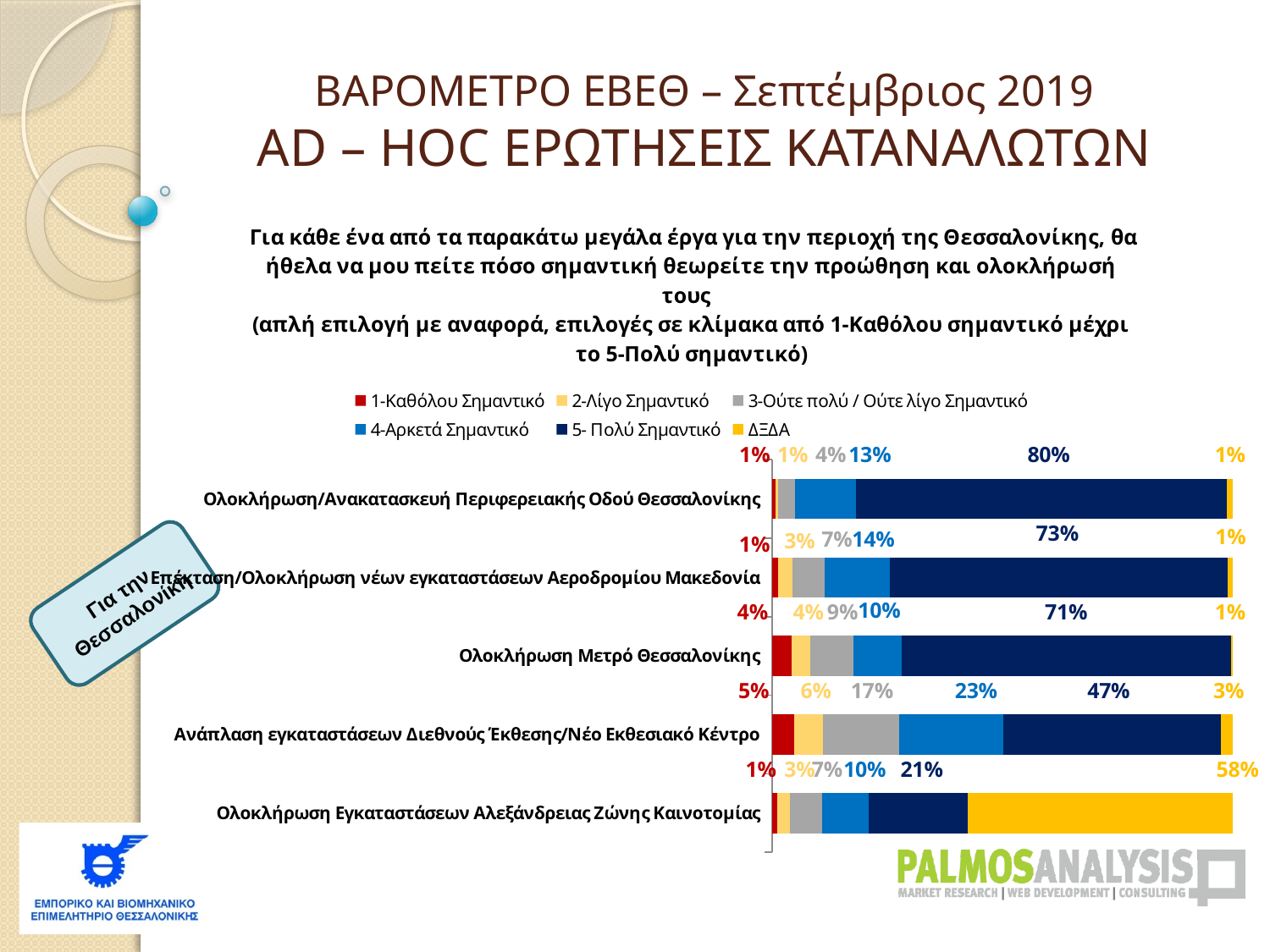
Which colour represents the '5- Πολύ Σημαντικό' series in the chart? Dark blue Which project has the lowest '5- Πολύ Σημαντικό' value? Ολοκλήρωση Εγκαταστάσεων Αλεξάνδρειας Ζώνης Καινοτομίας How many projects (categories) are plotted in the chart? 5 What is the '5- Πολύ Σημαντικό' value for Ολοκλήρωση/Ανακατασκευή Περιφερειακής Οδού Θεσσαλονίκης? 80% What is the difference between the '5- Πολύ Σημαντικό' values for Ολοκλήρωση/Ανακατασκευή Περιφερειακής Οδού Θεσσαλονίκης and Ολοκλήρωση Μετρό Θεσσαλονίκης? 9% What is the '4-Αρκετά Σημαντικό' value for Ανάπλαση εγκαταστάσεων Διεθνούς Έκθεσης/Νέο Εκθεσιακό Κέντρο? 23% What is the '3-Ούτε πολύ / Ούτε λίγο Σημαντικό' value for Ολοκλήρωση Μετρό Θεσσαλονίκης? 9% What kind of chart is shown on the slide? Stacked bar chart What is the 'ΔΞΔΑ' value for Ολοκλήρωση Εγκαταστάσεων Αλεξάνδρειας Ζώνης Καινοτομίας? 58% How many series does the legend list? 6 Which project has the highest '5- Πολύ Σημαντικό' value? Ολοκλήρωση/Ανακατασκευή Περιφερειακής Οδού Θεσσαλονίκης Which is larger: the '1-Καθόλου Σημαντικό' value for Ανάπλαση εγκαταστάσεων Διεθνούς Έκθεσης/Νέο Εκθεσιακό Κέντρο or for Ολοκλήρωση Μετρό Θεσσαλονίκης? Ανάπλαση εγκαταστάσεων Διεθνούς Έκθεσης/Νέο Εκθεσιακό Κέντρο